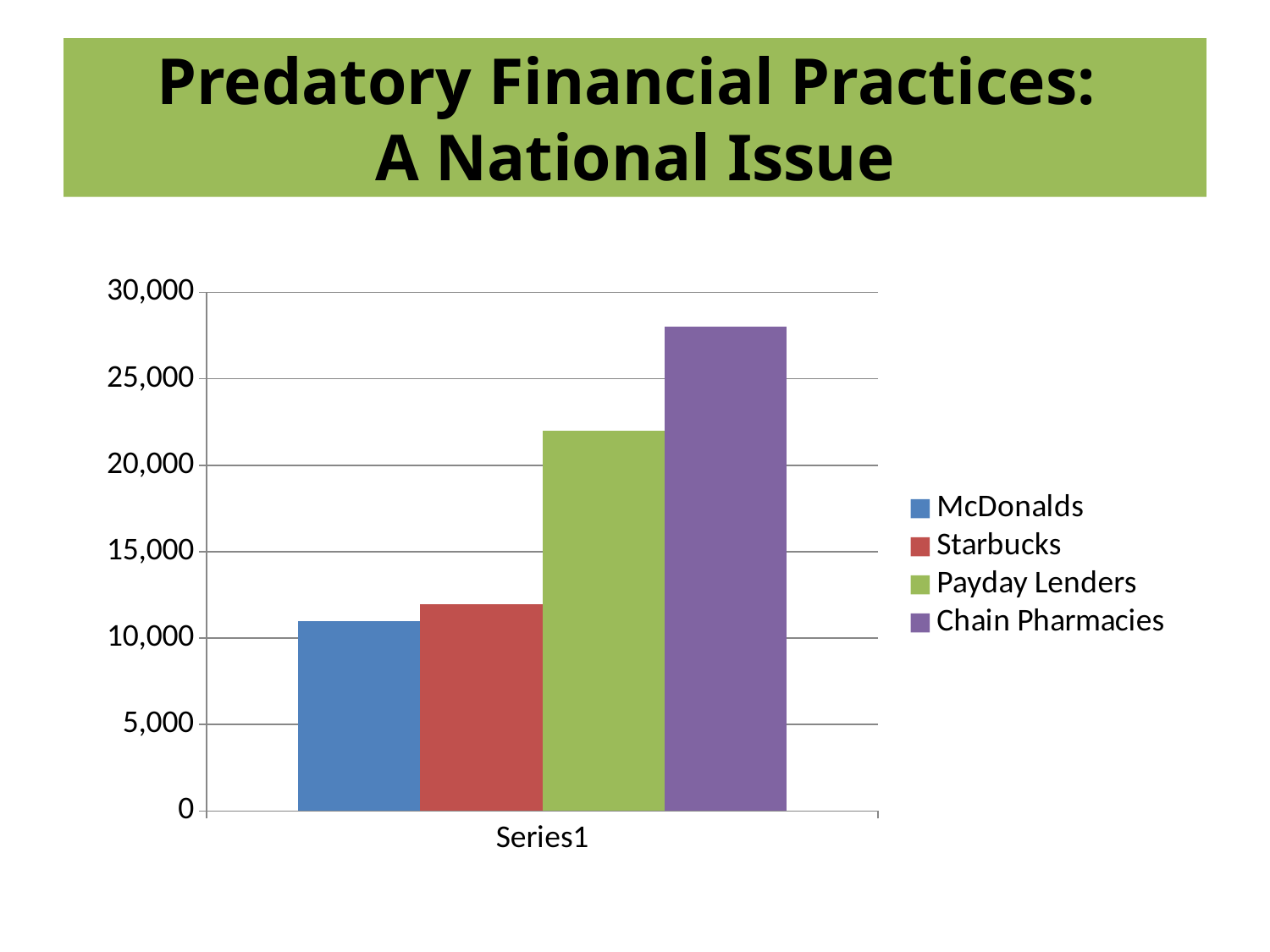
Is the value for Chain Pharmacies greater or less than 25,000? greater What kind of chart is shown on the slide? bar chart Which legend entry has the tallest bar? Chain Pharmacies How many series does the legend list? 4 Is the value for McDonalds greater or less than 15,000? less Is the value for Starbucks greater or less than 10,000? greater How many bars are plotted in the chart? 4 Which legend entry has the shortest bar? McDonalds What label appears on the horizontal axis below the bars? Series1 Which is larger, the value for Payday Lenders or the value for Starbucks? Payday Lenders